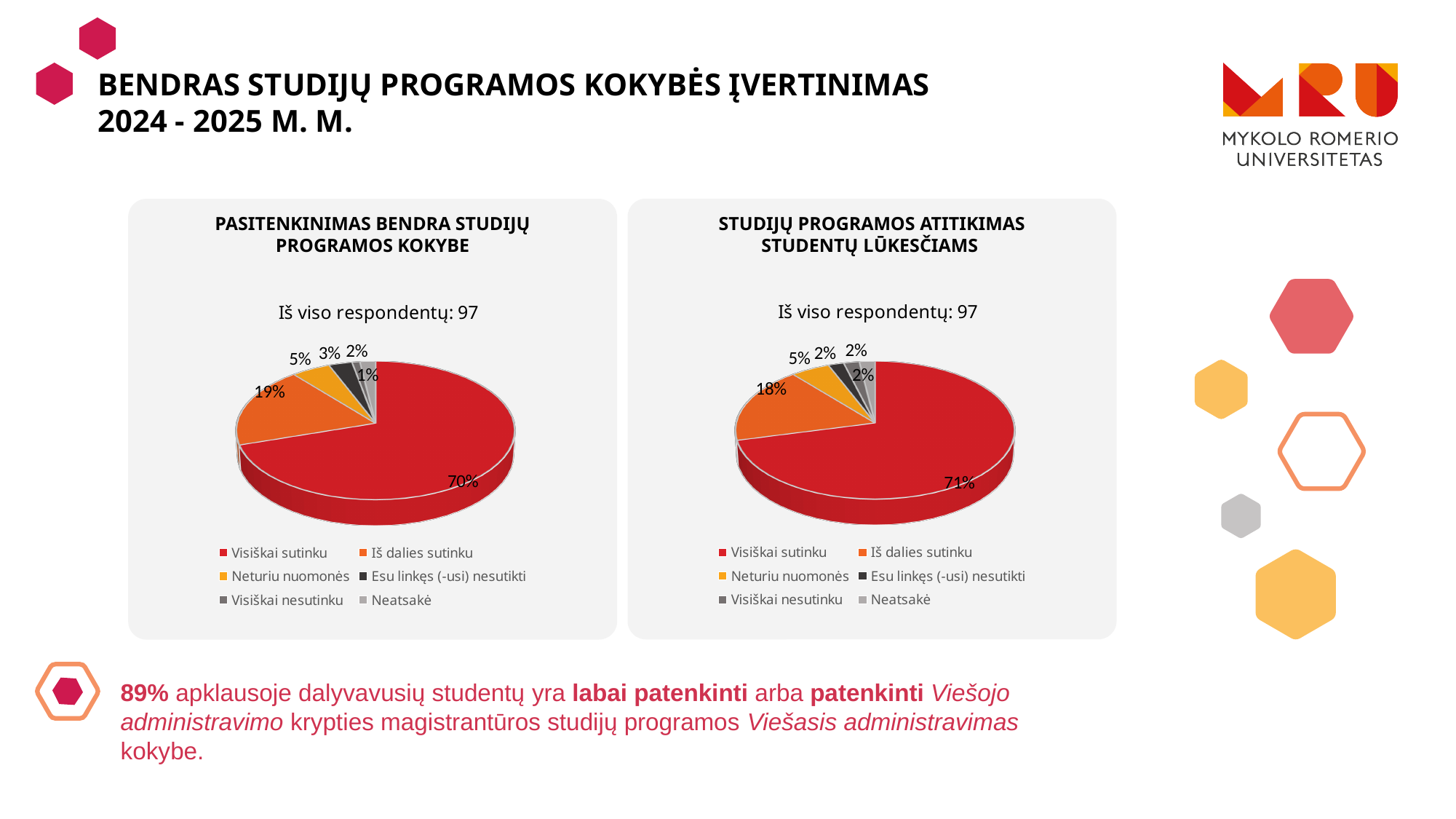
In the left chart (Pasitenkinimas bendra studijų programos kokybe), what share of respondents answered "Iš dalies sutinku"? 19% How many answer categories does the legend of the left chart (Pasitenkinimas bendra studijų programos kokybe) list? 6 In the left chart (Pasitenkinimas bendra studijų programos kokybe), which answer category has the largest slice? Visiškai sutinku What type of chart is used on this slide? Pie chart In the left chart (Pasitenkinimas bendra studijų programos kokybe), what share of respondents answered "Visiškai sutinku"? 70% In the left chart (Pasitenkinimas bendra studijų programos kokybe), what is the difference between the "Visiškai sutinku" and "Iš dalies sutinku" shares? 51% In the right chart (Studijų programos atitikimas studentų lūkesčiams), what is the difference between the "Visiškai sutinku" and "Iš dalies sutinku" shares? 53% In the right chart (Studijų programos atitikimas studentų lūkesčiams), what share of respondents answered "Visiškai sutinku"? 71% Which chart has the larger "Visiškai sutinku" share, the left one (Pasitenkinimas bendra studijų programos kokybe) or the right one (Studijų programos atitikimas studentų lūkesčiams)? The right chart (71%) How many respondents in total are reported for the right chart (Studijų programos atitikimas studentų lūkesčiams)? 97 In the right chart (Studijų programos atitikimas studentų lūkesčiams), what share of respondents answered "Iš dalies sutinku"? 18% In the left chart (Pasitenkinimas bendra studijų programos kokybe), which answer category has the smallest slice? Visiškai nesutinku